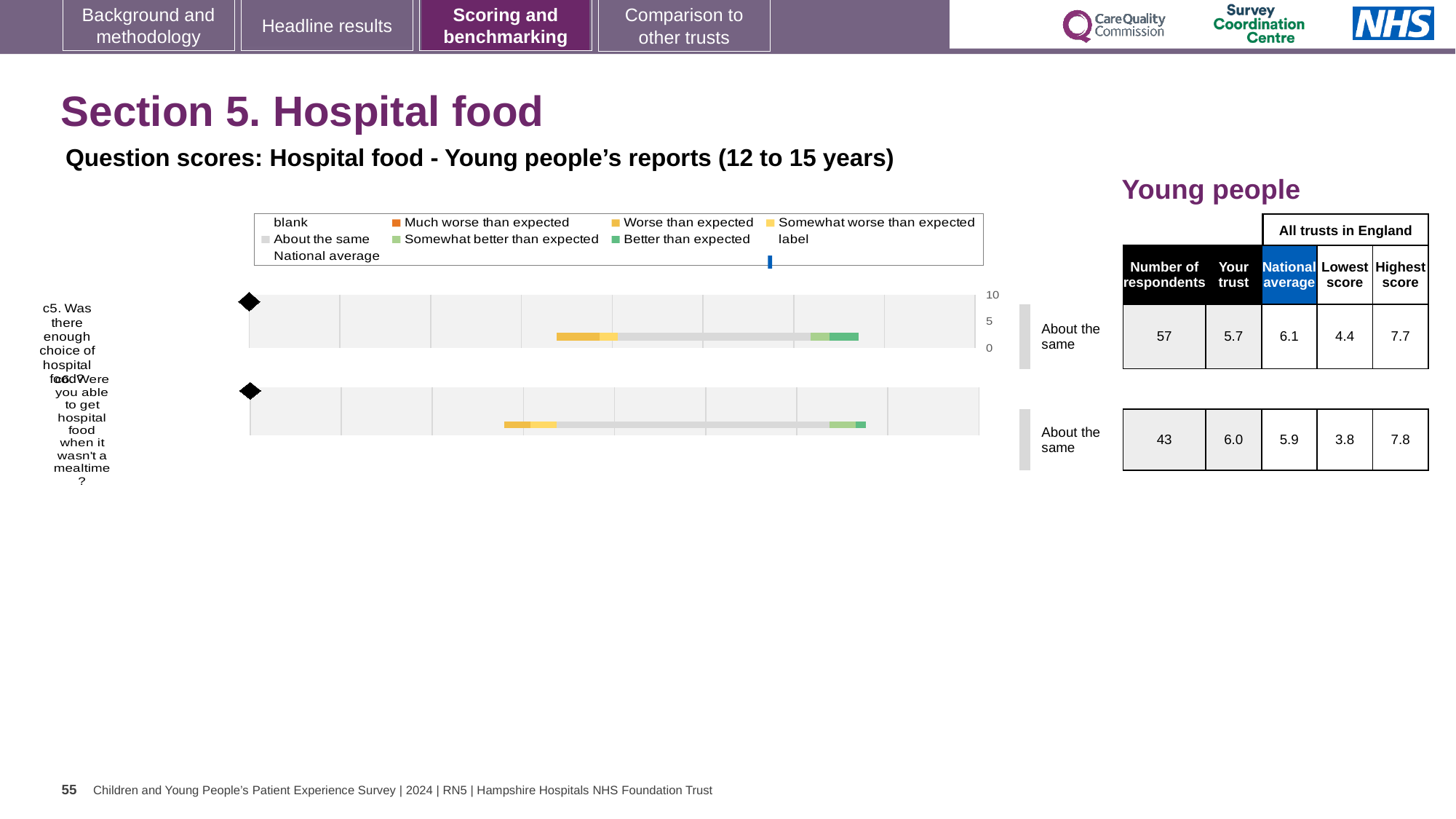
What is the difference between the highest and lowest scores for question c6? 4.0 What benchmark category is shown for both c5 and c6 in the chart? About the same How many respondents answered question c5? 57 What is the difference between the national average and the 'Your trust' score for question c5? 0.4 What kind of chart is used to show the question scores for hospital food? bar chart What is the 'Your trust' score for question c5 (enough choice of hospital food)? 5.7 For question c5, is the 'Your trust' score higher or lower than the national average? lower What is the lowest score among all trusts in England for question c5? 4.4 How many questions (categories) are plotted in the hospital food chart? 2 What is the national average score for question c6 (able to get hospital food when it wasn't a mealtime)? 5.9 Which question has more respondents, c5 or c6? c5 What is the highest score among all trusts in England for question c6? 7.8